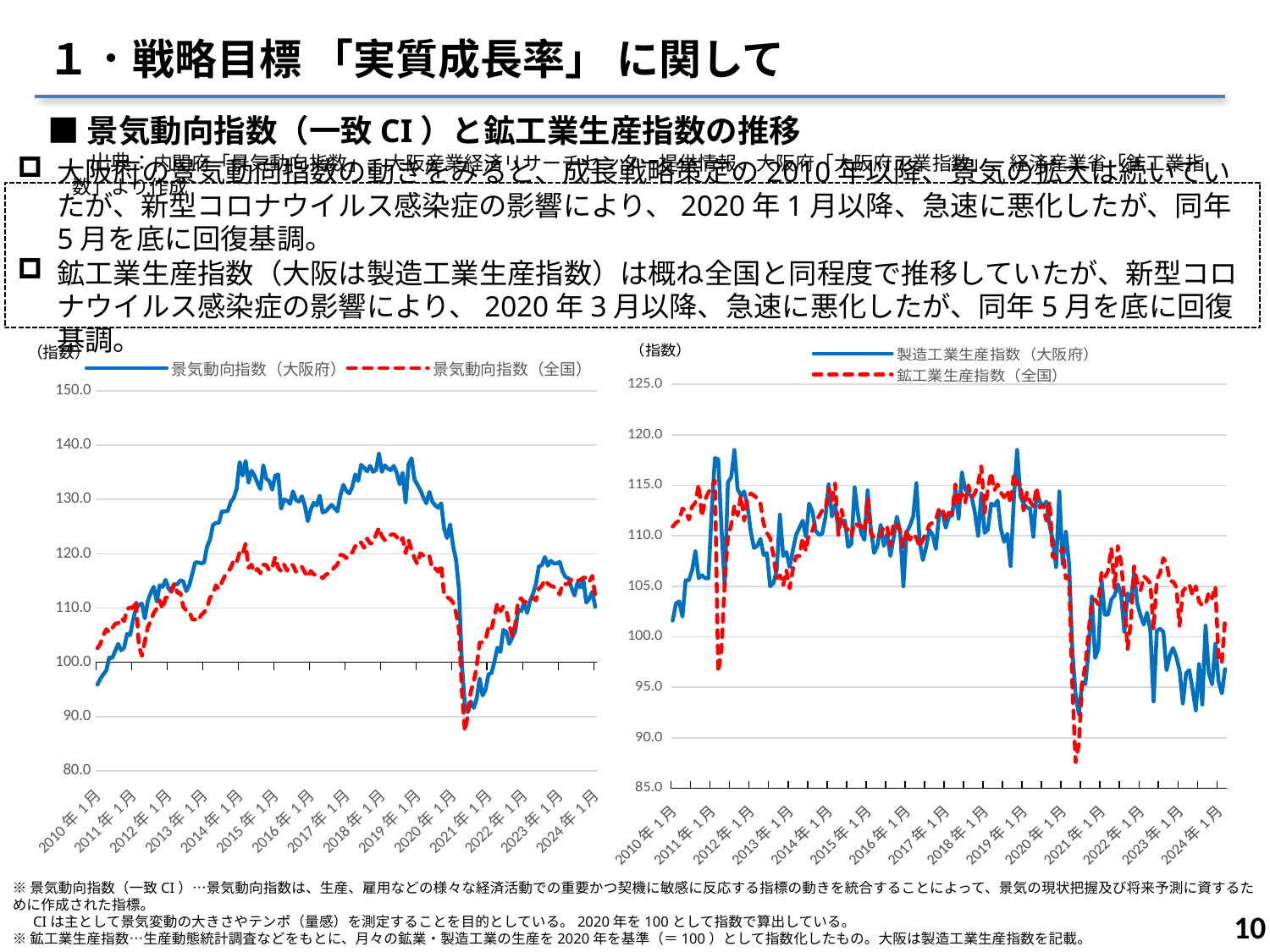
In the left chart, does 景気動向指数（大阪府） rise or fall between 2010年1月 and 2014年1月? rise In the right chart, what is the label of the solid blue series? 製造工業生産指数（大阪府） In the right chart, is the lowest value of 鉱工業生産指数（全国） in 2020 greater or less than 90? less How many series does the legend of the right chart (製造工業生産指数・鉱工業生産指数) list? 2 In the left chart, which series reaches the higher peak, 景気動向指数（大阪府） or 景気動向指数（全国）? 景気動向指数（大阪府） In the left chart, which series is drawn as a red dashed line? 景気動向指数（全国） In the right chart, does 製造工業生産指数（大阪府） rise or fall between 2019年1月 and mid-2020? fall In the right chart, which series falls to the lowest point in 2020? 鉱工業生産指数（全国） What kind of chart is the left chart (景気動向指数)? line chart In the right chart, is the value of 製造工業生産指数（大阪府） at 2023年1月 greater or less than 105? less In the left chart, is the value of 景気動向指数（大阪府） at 2018年1月 greater or less than 130? greater